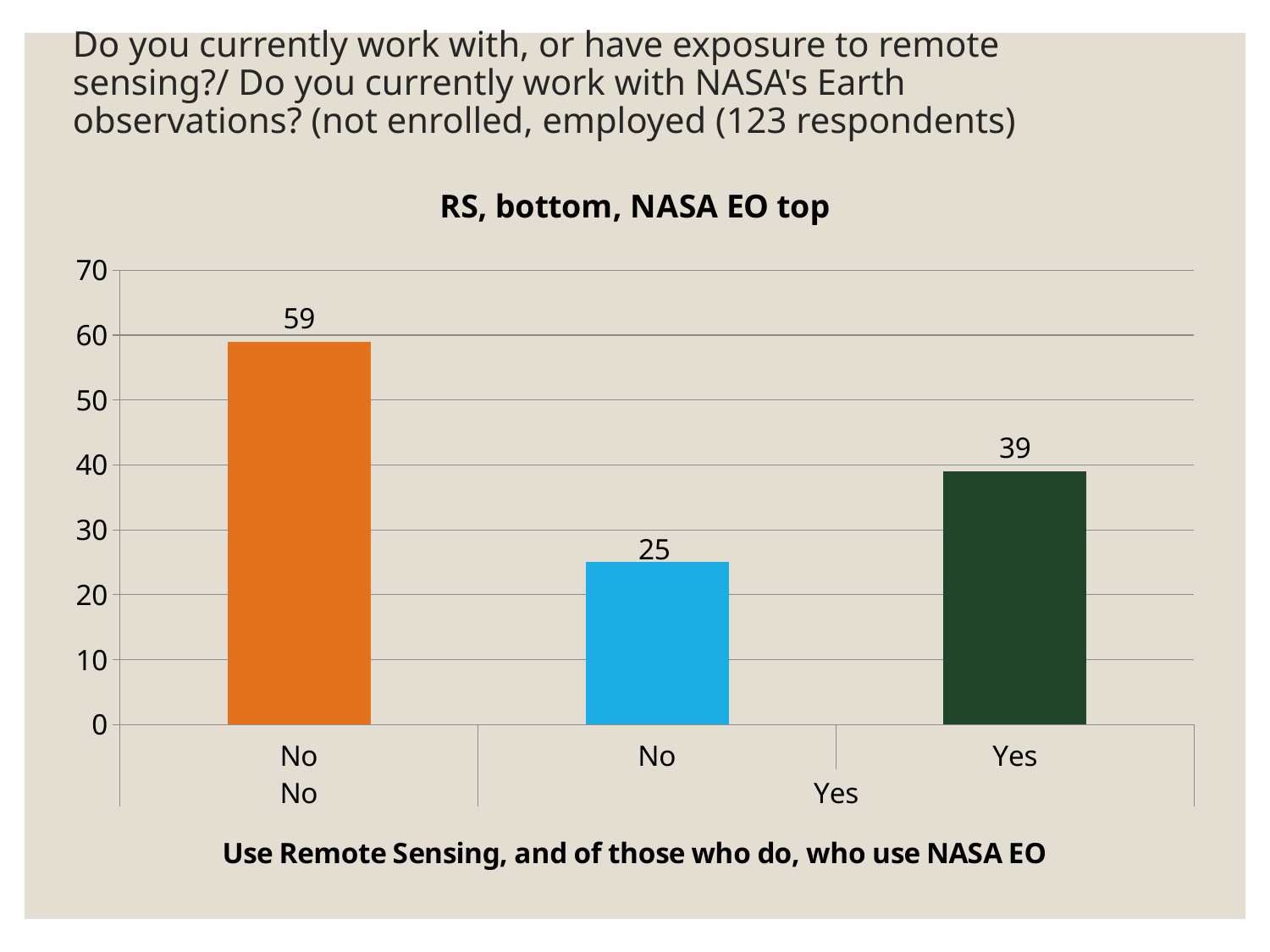
What type of chart is shown on the slide? Bar chart Which is larger: the value for those who use remote sensing and NASA EO (Yes/Yes) or those who use remote sensing but not NASA EO (Yes/No)? Yes/Yes (39) Is the value of the orange bar greater or less than 50? greater What is the value of the dark green bar (Yes remote sensing, Yes NASA EO)? 39 Which bar has the lowest value? Yes / No (blue bar), 25 What is the value of the orange bar (No remote sensing, No NASA EO)? 59 Which bar has the highest value? No / No (orange bar), 59 What is the difference between the dark green bar (39) and the blue bar (25)? 14 What is the title of the chart? RS, bottom, NASA EO top What is the difference between the orange bar (59) and the dark green bar (39)? 20 What is the value of the blue bar (Yes remote sensing, No NASA EO)? 25 How many bars are plotted in the chart? 3